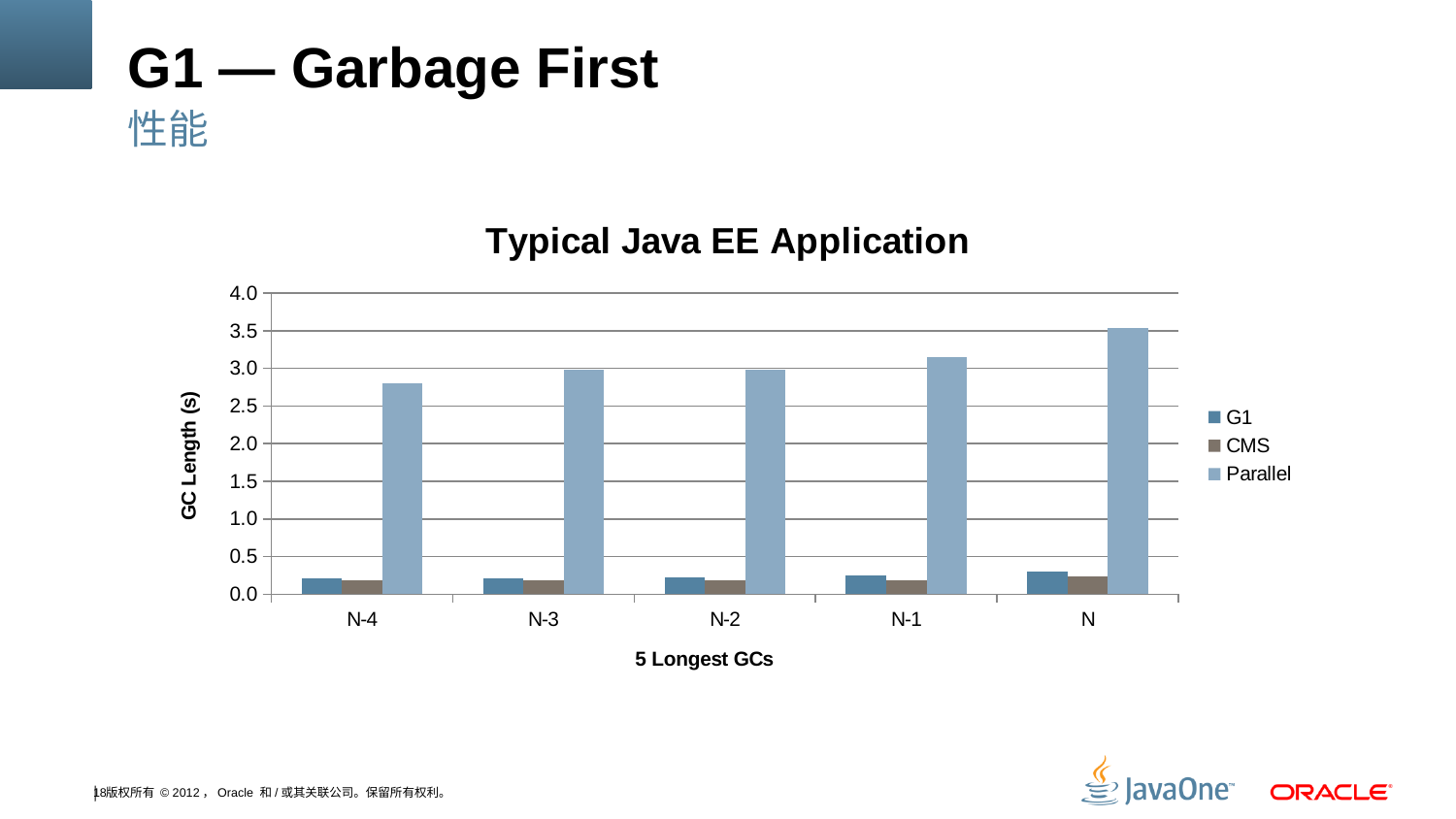
How many categories are shown on the x axis? 5 What is the title of the chart? Typical Java EE Application Which series has the larger value for N: G1 or Parallel? Parallel For which category is the Parallel value lowest? N-4 Do the Parallel values generally rise or fall from N-4 to N? rise For which category is the Parallel value highest? N Is the Parallel value for N-4 greater or less than 3.0? less How many series does the legend list? 3 What is the label of the y axis? GC Length (s) What kind of chart is shown on the slide? bar chart Is the G1 value for N greater or less than 0.5? less Is the Parallel value for N greater or less than 3.0? greater